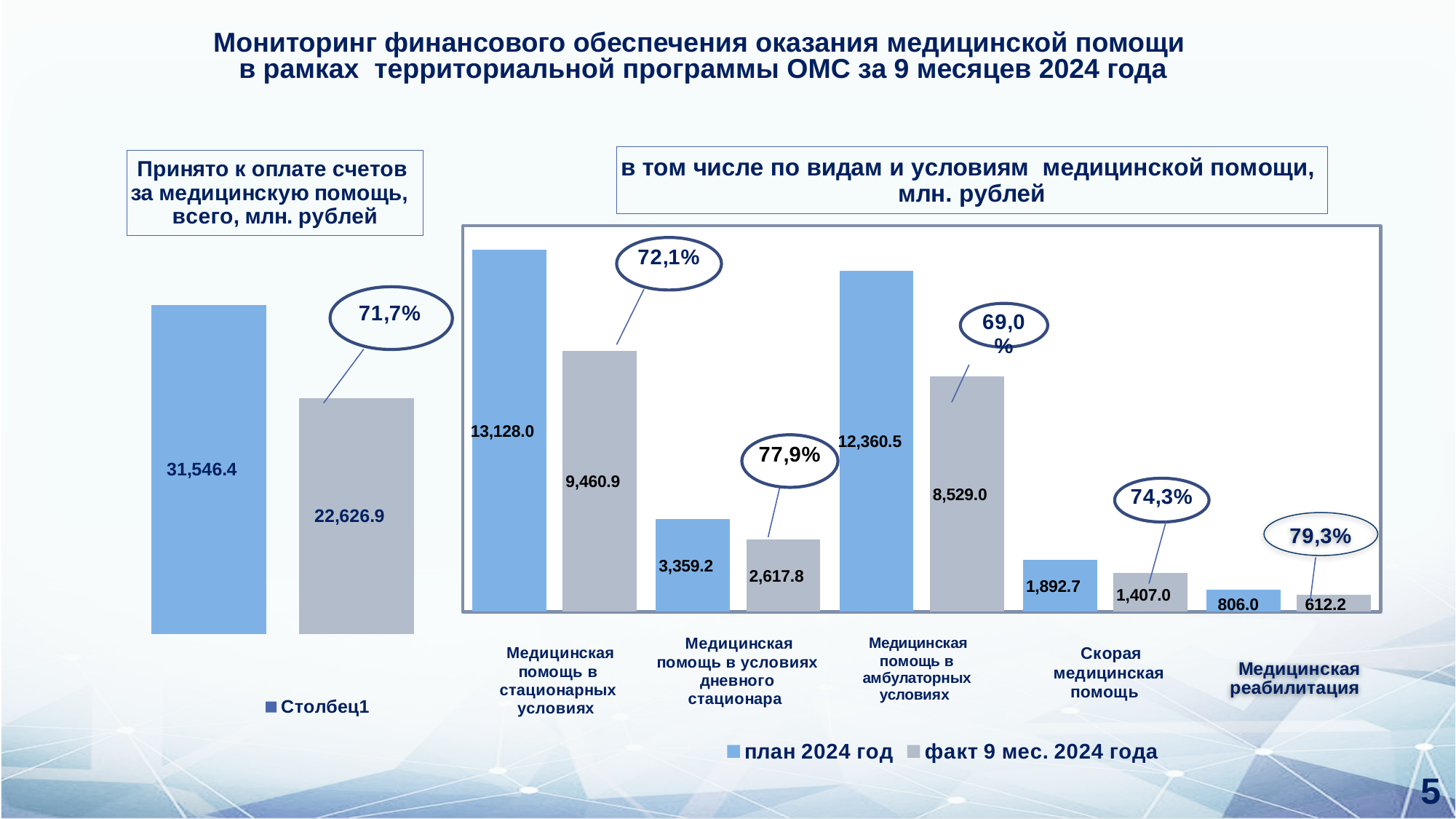
In the right chart 'в том числе по видам и условиям медицинской помощи, млн. рублей', what is the 'план 2024 год' value for 'Медицинская помощь в стационарных условиях'? 13,128.0 How many categories are shown on the x axis of the right chart 'в том числе по видам и условиям медицинской помощи, млн. рублей'? 5 In the right chart 'в том числе по видам и условиям медицинской помощи, млн. рублей', which category has the lowest 'план 2024 год' value? Медицинская реабилитация What type of chart is the left chart 'Принято к оплате счетов за медицинскую помощь, всего, млн. рублей'? Bar chart In the left chart 'Принято к оплате счетов за медицинскую помощь, всего, млн. рублей', what is the difference between the blue bar and the grey bar? 8,919.5 In the right chart 'в том числе по видам и условиям медицинской помощи, млн. рублей', what is the difference between the 'план 2024 год' and 'факт 9 мес. 2024 года' values for 'Медицинская помощь в условиях дневного стационара'? 741.4 How many series does the legend of the right chart 'в том числе по видам и условиям медицинской помощи, млн. рублей' list? 2 In the left chart 'Принято к оплате счетов за медицинскую помощь, всего, млн. рублей', what is the value of the grey bar? 22,626.9 In the right chart 'в том числе по видам и условиям медицинской помощи, млн. рублей', what is the 'факт 9 мес. 2024 года' value for 'Скорая медицинская помощь'? 1,407.0 In the right chart 'в том числе по видам и условиям медицинской помощи, млн. рублей', what is the 'факт 9 мес. 2024 года' value for 'Медицинская помощь в амбулаторных условиях'? 8,529.0 In the right chart 'в том числе по видам и условиям медицинской помощи, млн. рублей', which is larger: the 'план 2024 год' value for 'Медицинская помощь в стационарных условиях' or for 'Медицинская помощь в амбулаторных условиях'? Медицинская помощь в стационарных условиях In the right chart 'в том числе по видам и условиям медицинской помощи, млн. рублей', which category has the highest 'факт 9 мес. 2024 года' value? Медицинская помощь в стационарных условиях